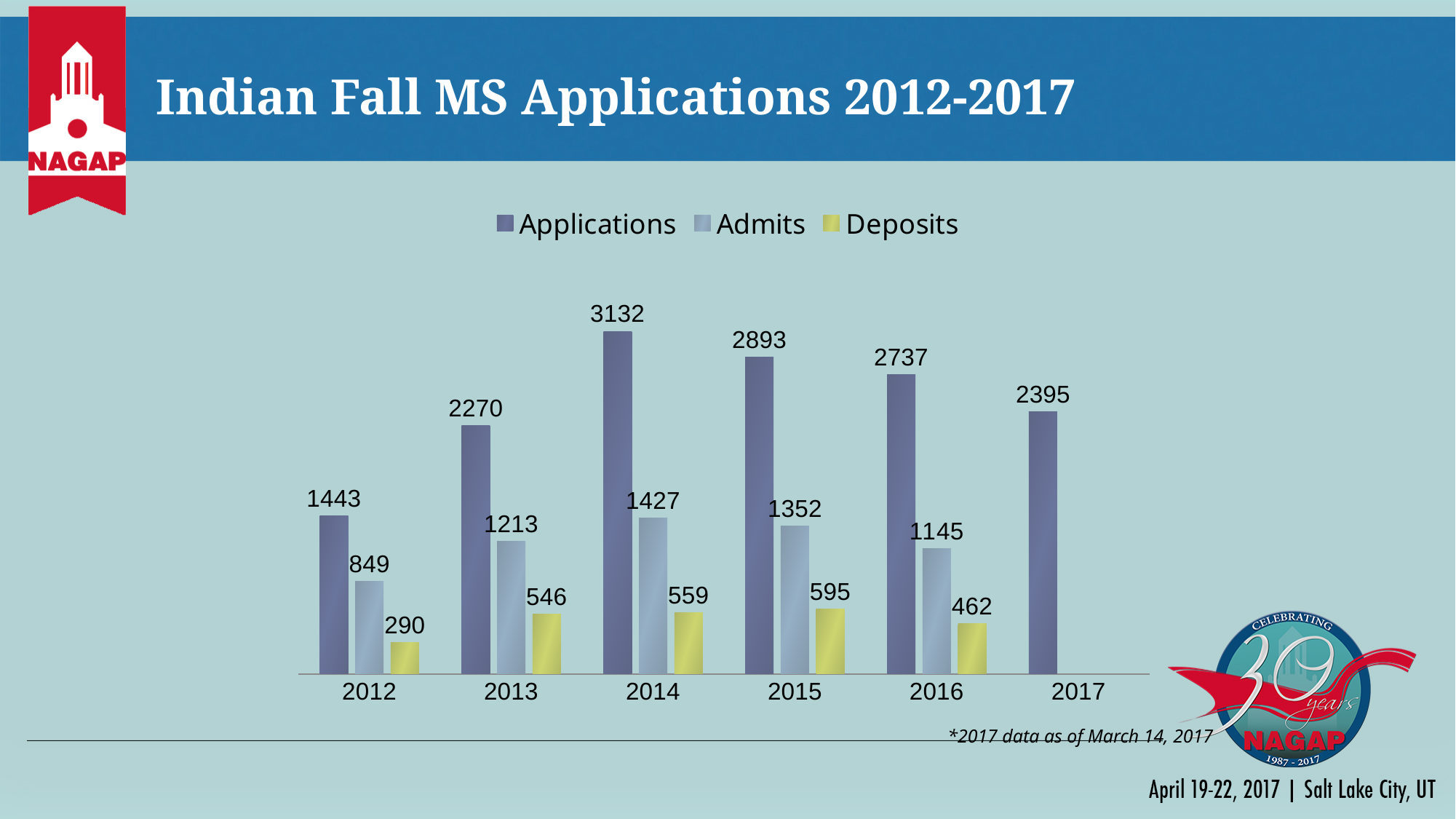
What is the number of Deposits in 2016? 462 What is the number of Admits in 2013? 1213 Which year has the highest number of Applications? 2014 Which year has the lowest number of Deposits? 2012 Do Applications rise or fall from 2014 to 2017? Fall What is the title of the chart? Indian Fall MS Applications 2012-2017 What is the number of Applications in 2014? 3132 How many series does the legend list? 3 Which is larger: Admits in 2015 or Admits in 2016? Admits in 2015 How many years are shown on the x axis? 6 What kind of chart is shown on the slide? Bar chart What is the difference between Applications in 2014 and Applications in 2015? 239